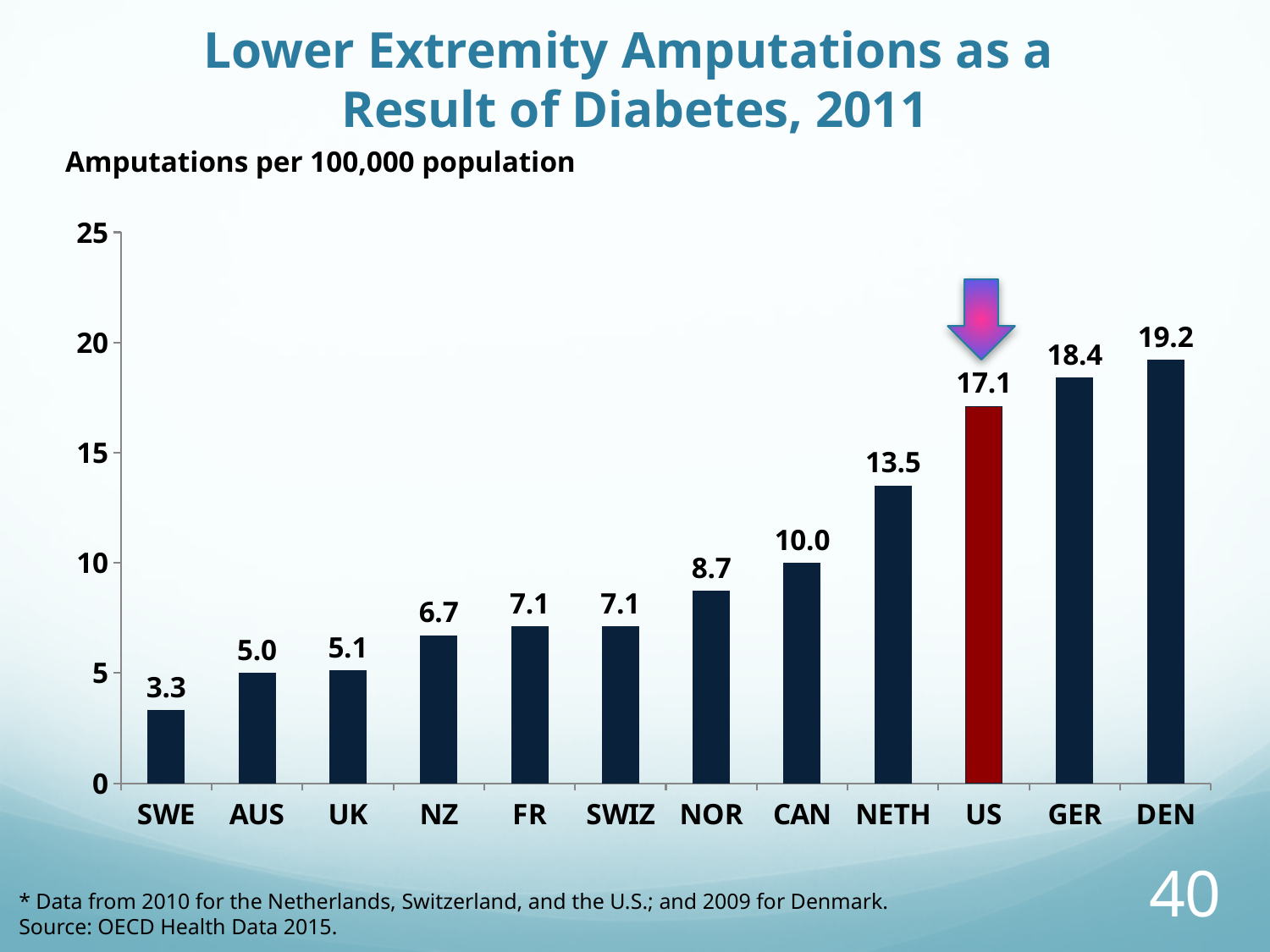
What is the value for the US? 17.1 What is the value for SWE? 3.3 What is the difference between the values for DEN and the US? 2.1 Which country has the lowest value? SWE What is the difference between the values for CAN and NOR? 1.3 How many countries are shown on the chart? 12 Do the values rise or fall from left to right along the x axis? rise Which bar is coloured red rather than dark blue? US Which is larger, the value for GER or the value for NETH? GER What is the value for NETH? 13.5 Which country has the highest value? DEN What kind of chart is shown on the slide? bar chart